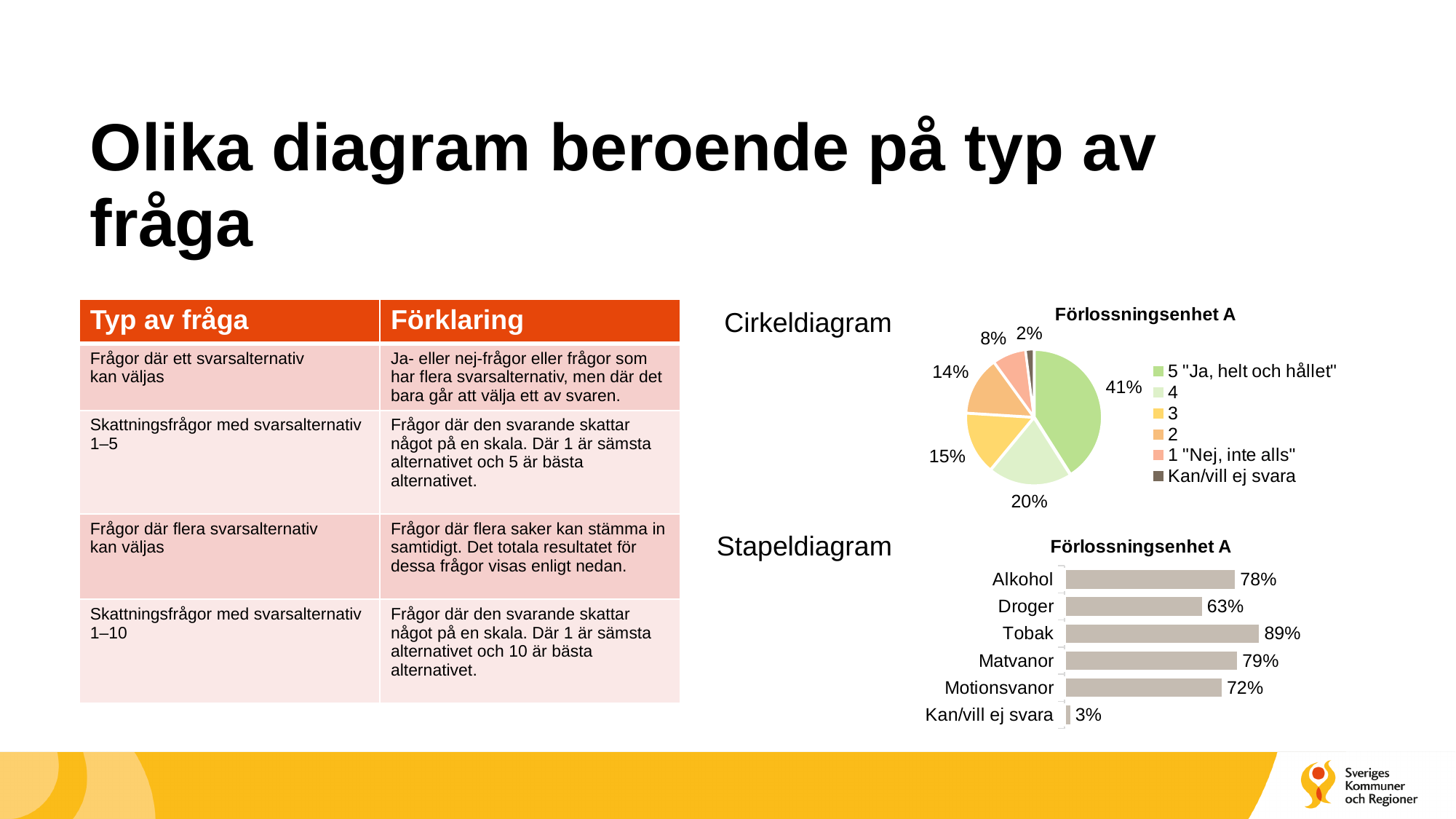
In the bar chart at the bottom right, which is larger, Alkohol or Motionsvanor? Alkohol In the bar chart at the bottom right, which category has the lowest value? Kan/vill ej svara In the pie chart at the top right, what is the difference between the slice labelled 41% and the slice labelled 20%? 21% In the bar chart at the bottom right, how many categories are plotted? 6 In the bar chart at the bottom right, which category has the highest value? Tobak In the pie chart at the top right, which legend category has the largest slice? 5 "Ja, helt och hållet" In the pie chart at the top right, what percentage is shown for the slice Kan/vill ej svara? 2% In the pie chart at the top right, how many entries does the legend list? 6 In the pie chart at the top right, what share is labelled for the slice 5 "Ja, helt och hållet"? 41% In the bar chart at the bottom right, what is the value for Droger? 63% In the bar chart at the bottom right, what is the value for Tobak? 89% In the bar chart at the bottom right, what is the difference between Matvanor and Droger? 16%